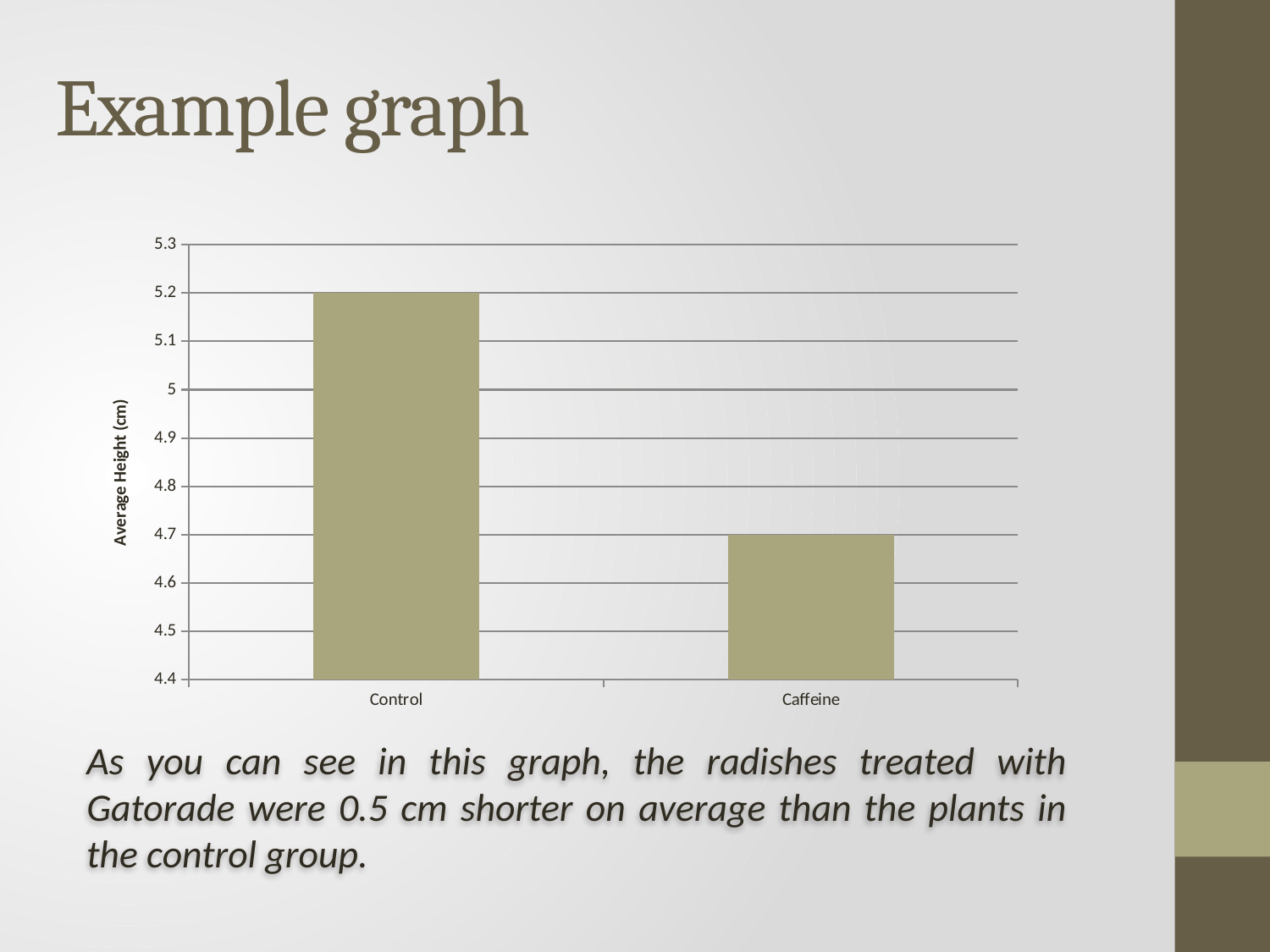
Is the value for Control greater or less than 5? greater What is the label of the y axis? Average Height (cm) What is the difference in average height between the Control and Caffeine groups? 0.5 Which is larger, the value for Control or the value for Caffeine? Control Is the value for Caffeine greater or less than 5? less What is the lowest value shown on the y axis? 4.4 What is the average height for the Control group? 5.2 How many categories are plotted on the x axis of the chart? 2 Which category has the lowest average height? Caffeine What kind of chart is shown on the slide? bar chart What is the average height for the Caffeine group? 4.7 Which category has the highest average height? Control